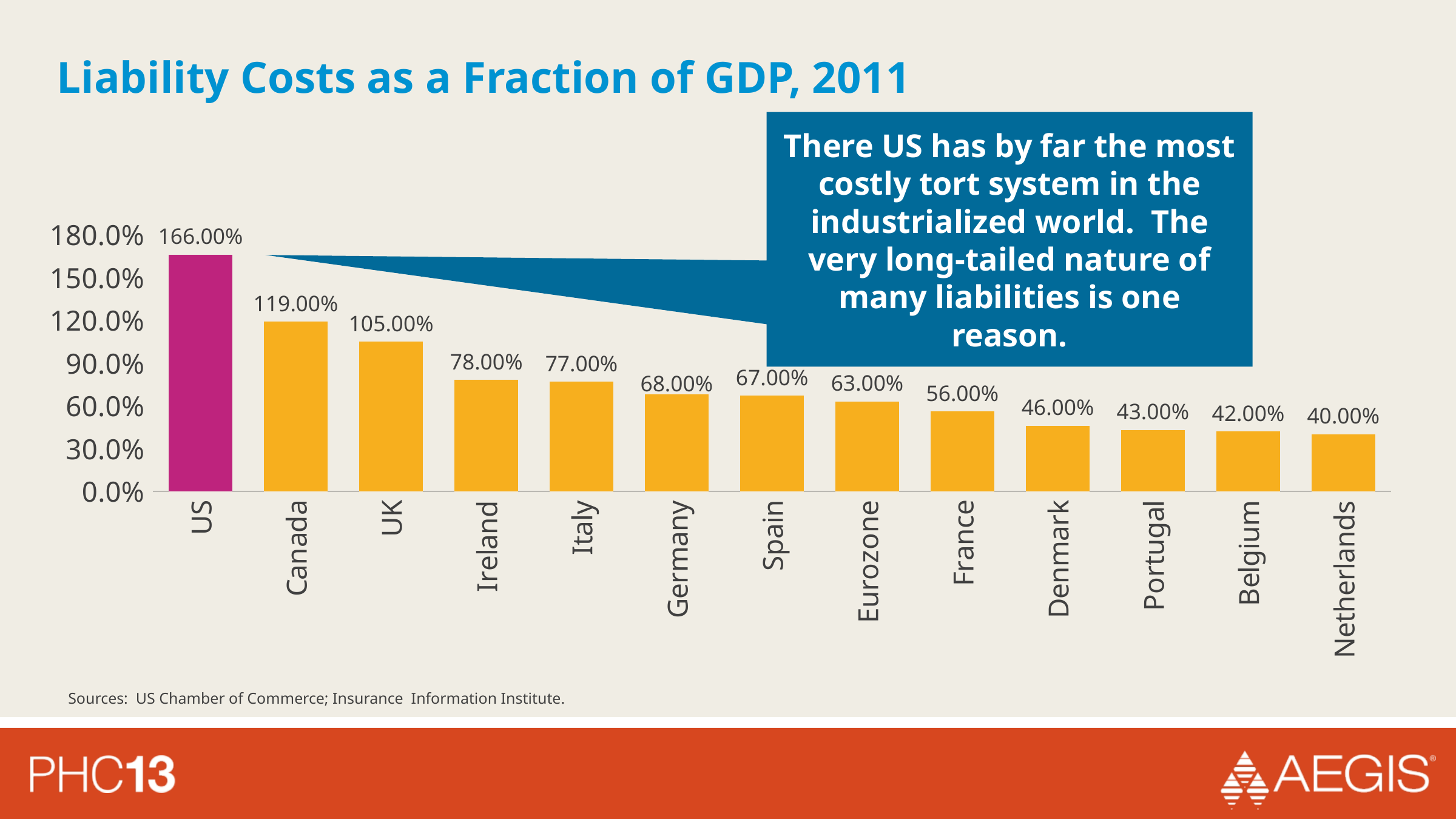
What is the difference between the values for the UK and France? 49.00% Which country has the highest liability cost as a fraction of GDP? US What kind of chart is shown on the slide? Bar chart What is the value for the US? 166.00% How many countries or regions are shown on the chart? 13 Which category has the lowest value? Netherlands Do the values rise or fall from left to right along the x axis? Fall What is the value for Canada? 119.00% What is the difference between the values for the US and Canada? 47.00% What is the value for Germany? 68.00% Which is larger, the value for Ireland or the value for Eurozone? Ireland What is the value for Netherlands? 40.00%